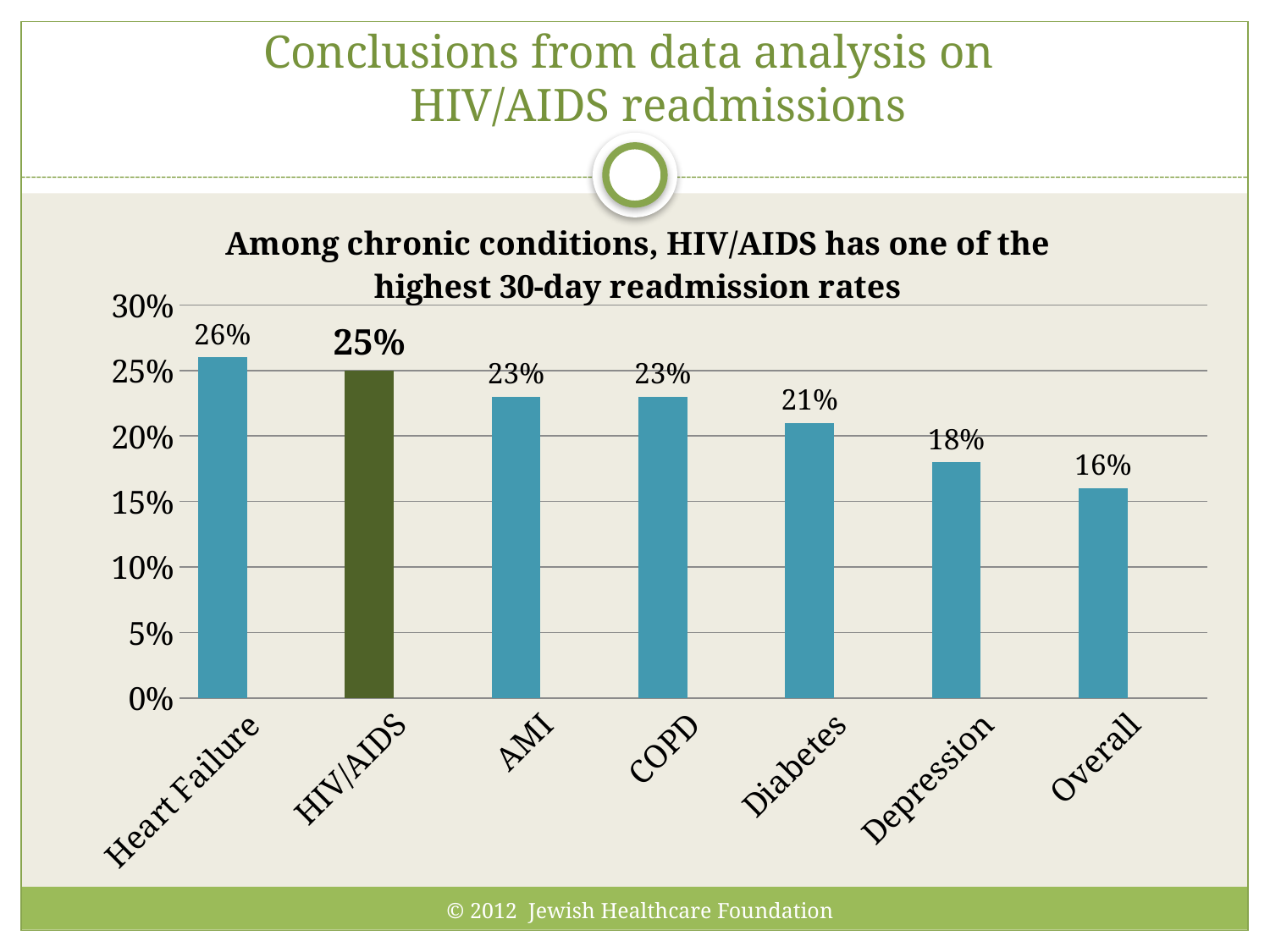
What is the 30-day readmission rate for HIV/AIDS? 25% Which category has the highest readmission rate? Heart Failure What is the readmission rate shown for Depression? 18% What is the readmission rate shown for Heart Failure? 26% What is the difference between the readmission rates for Heart Failure and Diabetes? 5% Which category has the lowest readmission rate? Overall Which has a higher readmission rate, Diabetes or Depression? Diabetes What is the difference between the readmission rates for HIV/AIDS and Overall? 9% What kind of chart is shown on the slide? Bar chart Is the value for COPD greater or less than 20%? greater How many categories are shown on the x axis? 7 Which bar is coloured differently (dark green) from the others? HIV/AIDS